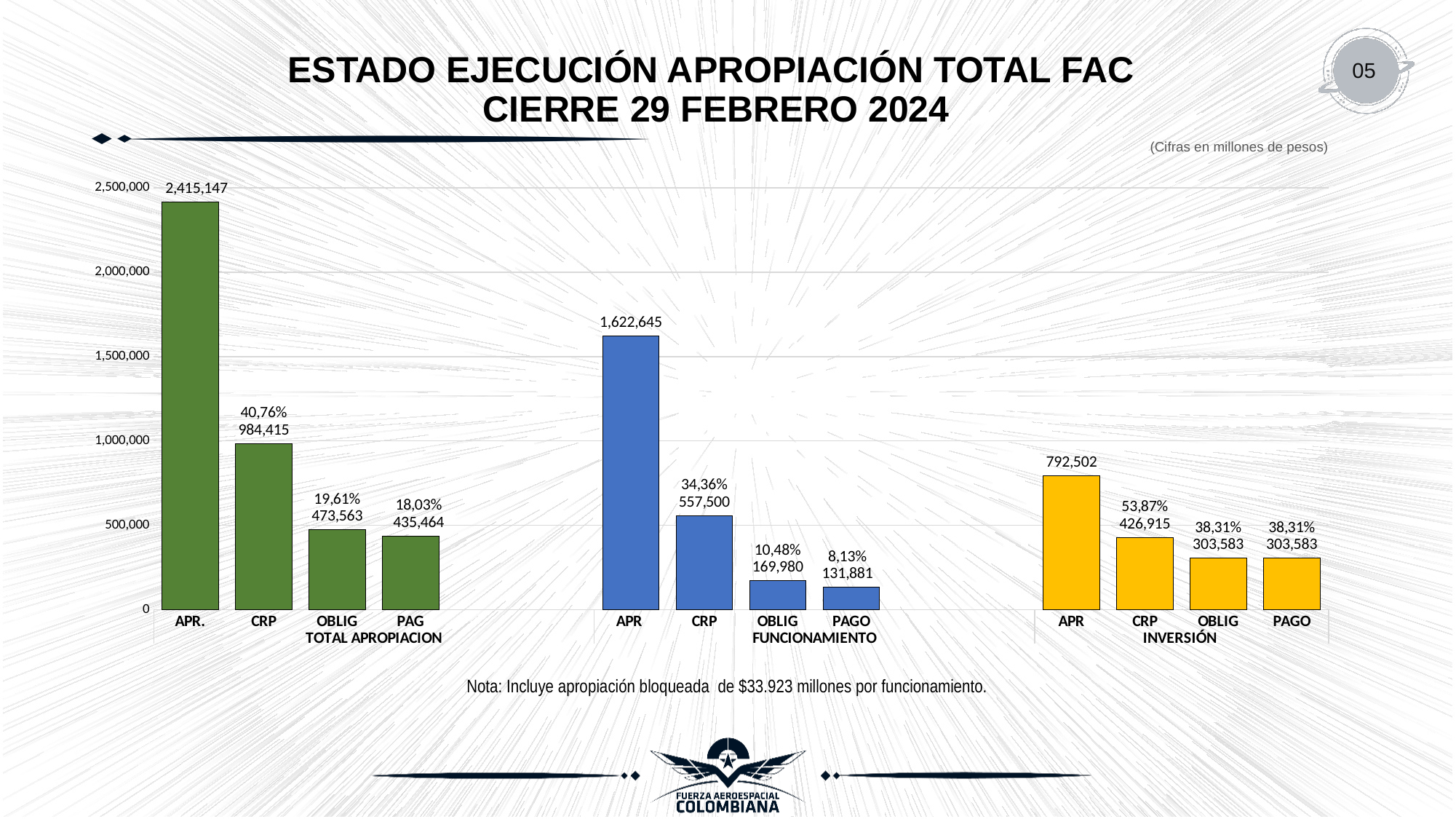
Is the value of the APR bar in the INVERSIÓN group greater or less than 500,000? greater Which is larger: the OBLIG value in FUNCIONAMIENTO or the OBLIG value in INVERSIÓN? OBLIG in INVERSIÓN What is the value of the CRP bar in the FUNCIONAMIENTO group? 557,500 How many bars are plotted on the chart in total? 12 What is the value of the APR. bar in the TOTAL APROPIACION group? 2,415,147 Which bar has the highest value on the chart? APR. in TOTAL APROPIACION What kind of chart is shown on the slide? Bar chart What is the difference between the APR. value in TOTAL APROPIACION and the APR value in FUNCIONAMIENTO? 792,502 What is the value of the PAGO bar in the INVERSIÓN group? 303,583 Which bar has the lowest value on the chart? PAGO in FUNCIONAMIENTO What colour are the bars in the INVERSIÓN group? Yellow What percentage is shown above the CRP bar in the INVERSIÓN group? 53,87%